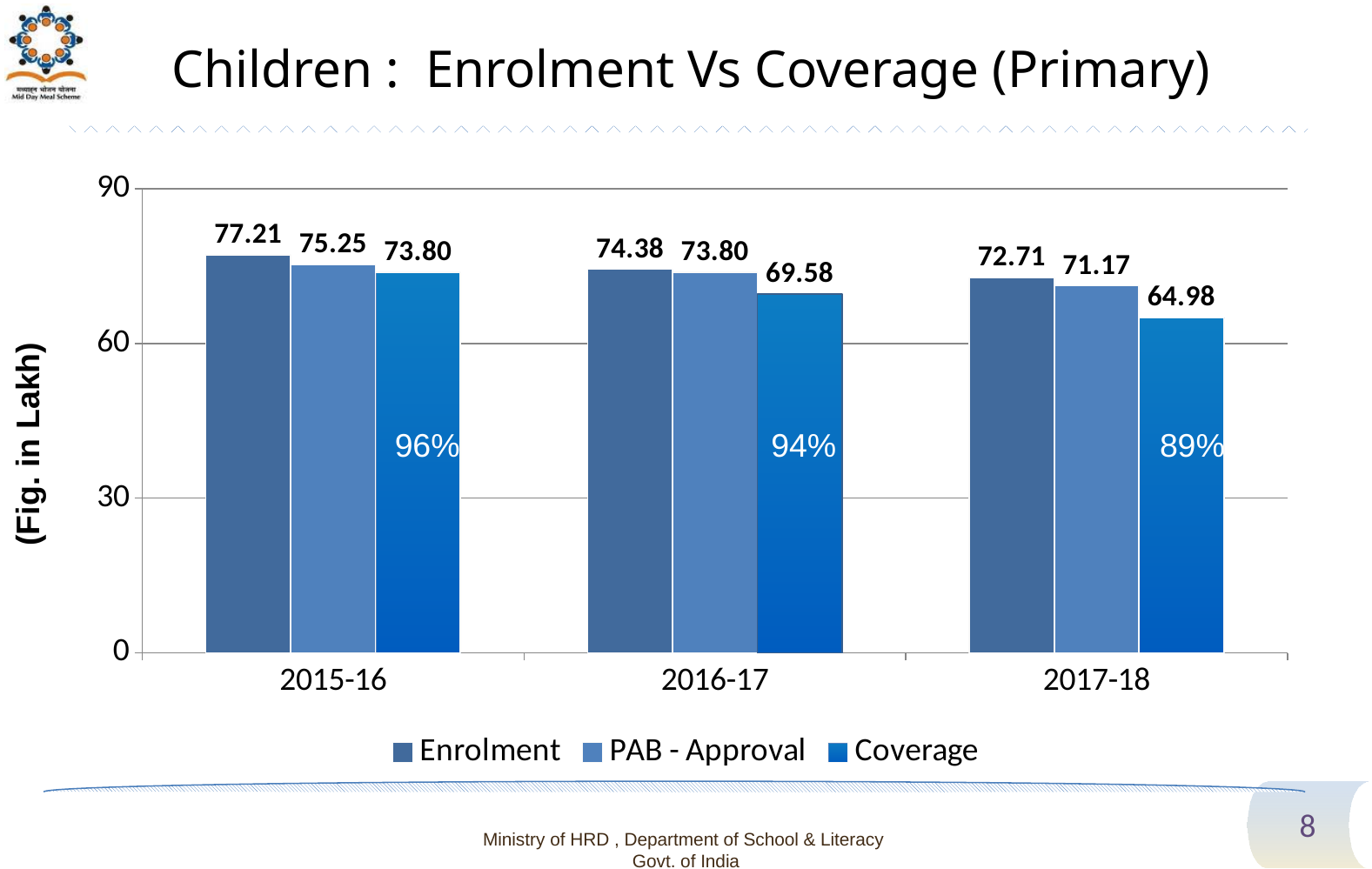
Is the Coverage value for 2016-17 greater or less than 60? greater What is the Coverage value for 2017-18? 64.98 Which is larger in 2016-17, Enrolment or Coverage? Enrolment Which year has the highest Enrolment value? 2015-16 How many series does the legend list? 3 What is the difference between Enrolment and Coverage in 2017-18? 7.73 What is the PAB - Approval value for 2016-17? 73.80 Does the Coverage value rise or fall from 2015-16 to 2017-18? fall What kind of chart is shown on the slide? bar chart How many years are shown on the x axis? 3 What is the Enrolment value for 2015-16? 77.21 Which year has the lowest Coverage value? 2017-18